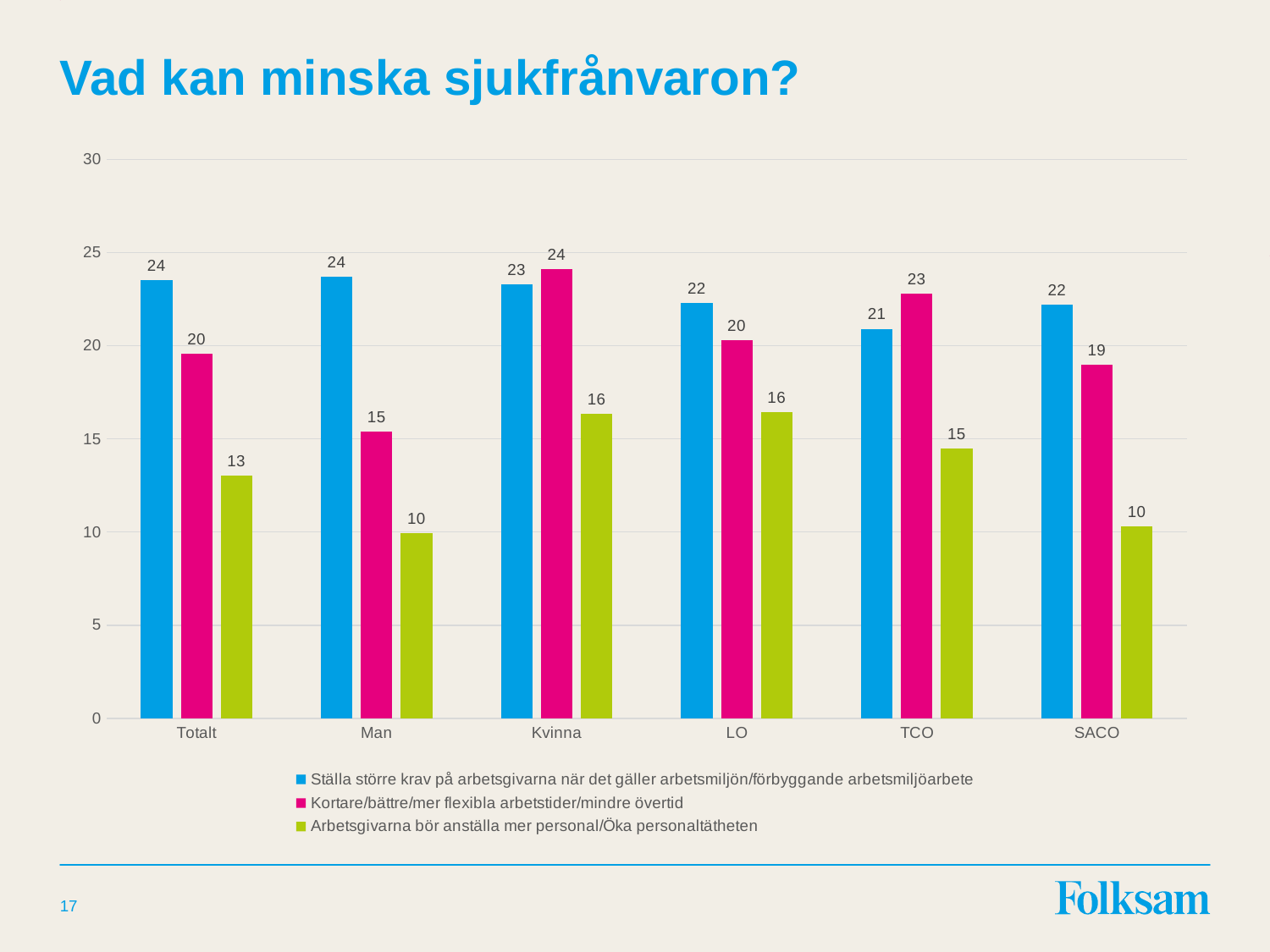
What is the value for TCO in the series "Ställa större krav på arbetsgivarna när det gäller arbetsmiljön/förbyggande arbetsmiljöarbete"? 21 How many series does the legend list? 3 What is the title of the slide? Vad kan minska sjukfrånvaron? What is the value for Man in the series "Arbetsgivarna bör anställa mer personal/Öka personaltätheten"? 10 What is the difference between the "Ställa större krav på arbetsgivarna" value and the "Arbetsgivarna bör anställa mer personal" value for Totalt? 11 Which category has the lowest value in the series "Kortare/bättre/mer flexibla arbetstider/mindre övertid"? Man Which category has the highest value in the series "Arbetsgivarna bör anställa mer personal/Öka personaltätheten"? Kvinna and LO (16) What is the value for Kvinna in the series "Kortare/bättre/mer flexibla arbetstider/mindre övertid"? 24 For TCO, which is larger: the "Ställa större krav på arbetsgivarna" value or the "Kortare/bättre/mer flexibla arbetstider" value? Kortare/bättre/mer flexibla arbetstider/mindre övertid What kind of chart is shown on the slide? bar chart Is the value for SACO in the series "Arbetsgivarna bör anställa mer personal/Öka personaltätheten" greater or less than 15? less How many categories are shown on the x axis? 6